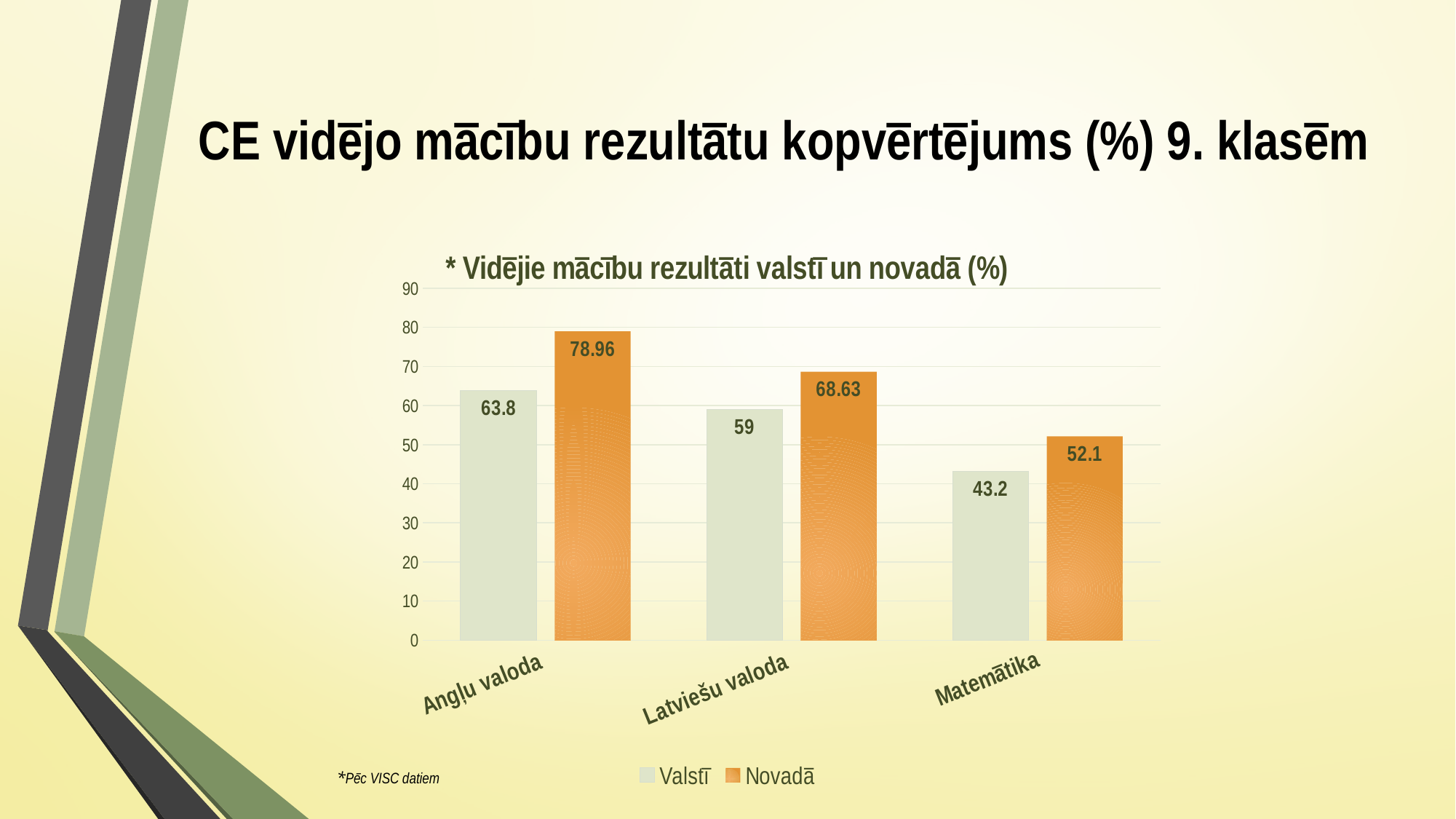
Which category has the lowest Valstī value? Matemātika What is the Valstī value for Latviešu valoda? 59 How many categories are shown on the x axis? 3 What is the difference between the Novadā and Valstī values for Matemātika? 8.9 What is the title of the chart? * Vidējie mācību rezultāti valstī un novadā (%) What is the Novadā value for Matemātika? 52.1 How many series does the legend list? 2 What is the Novadā value for Latviešu valoda? 68.63 What kind of chart is shown on the slide? Bar chart Which is larger for Angļu valoda, the Valstī value or the Novadā value? Novadā Which category has the highest Novadā value? Angļu valoda What is the Valstī value for Angļu valoda? 63.8